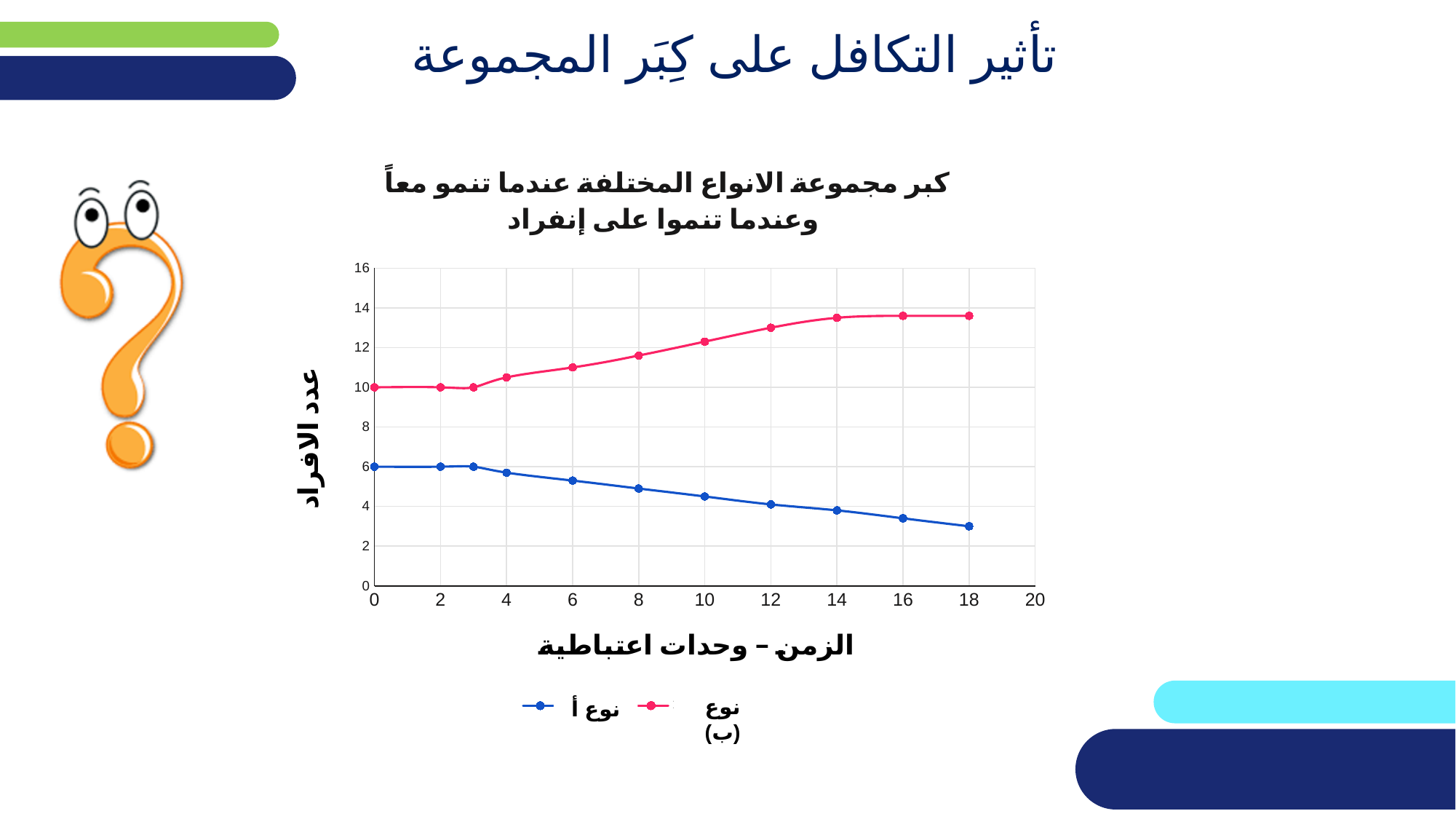
Does the value for نوع أ rise or fall as time increases along the x axis? fall Does the value for نوع (ب) rise or fall as time increases along the x axis? rise At time 18, which series has the larger value, نوع أ or نوع (ب)? نوع (ب) Is the value for نوع (ب) at time 18 greater or less than 12? greater What is the label of the y axis? عدد الافراد What is the value for نوع (ب) at time 0? 10 How many series does the legend list? 2 What are the two series named in the legend? نوع أ and نوع (ب) What kind of chart is shown on the slide? line chart How many data points are plotted for the نوع أ series? 11 What is the value for نوع أ at time 0? 6 Is the value for نوع أ at time 18 greater or less than 4? less